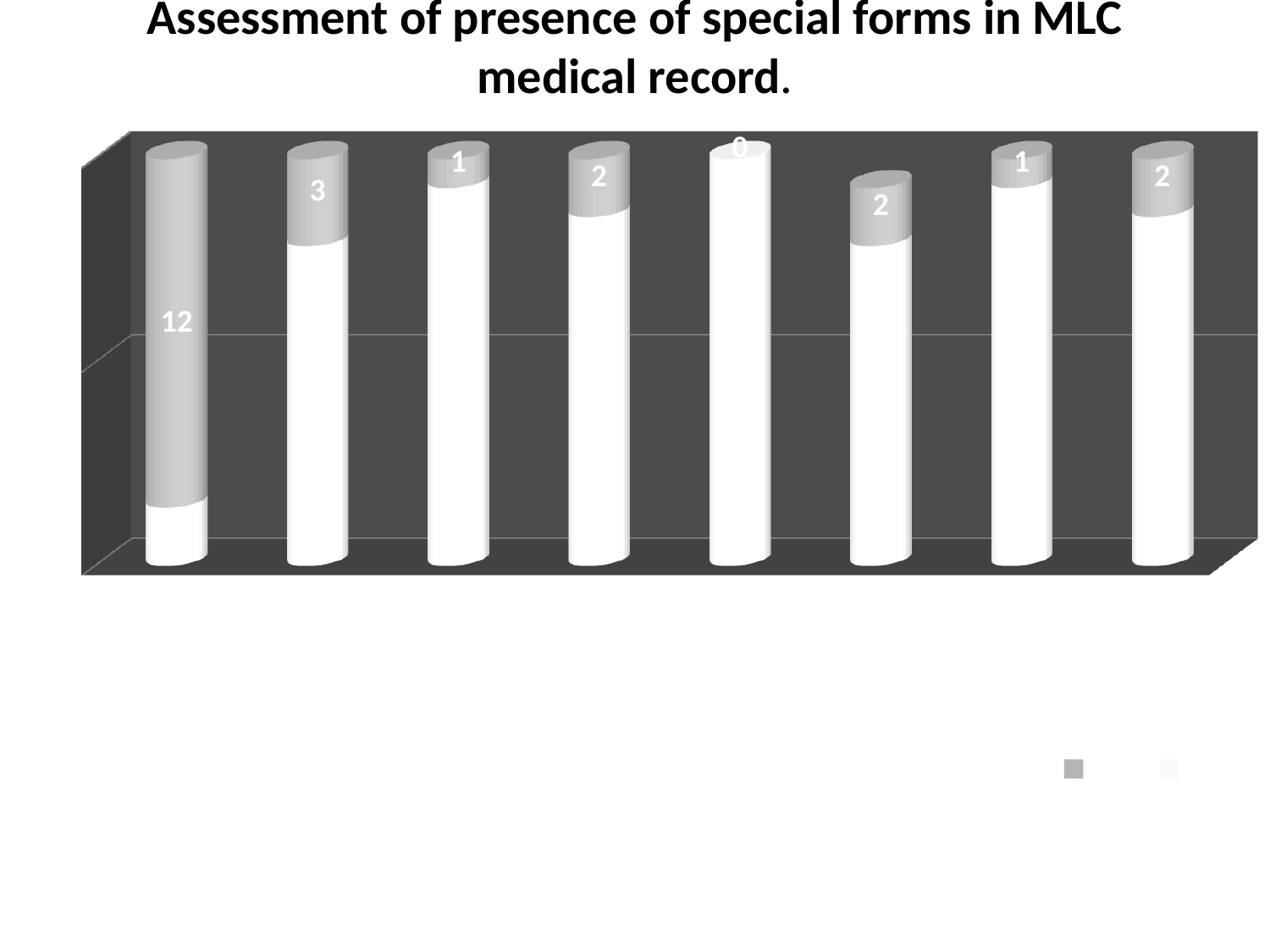
What is the labelled value of the grey segment on the fifth bar from the left? 0 What is the labelled value of the grey segment on the last bar on the right? 2 What kind of chart is shown on the slide? bar chart Which has the larger grey-segment value, the second bar from the left or the third bar from the left? the second bar from the left What is the difference between the grey-segment values of the first and second bars from the left? 9 Which bar has the highest labelled grey-segment value? the first bar from the left How many bars are plotted in the chart? 8 How many series does the legend list? 2 What is the labelled value of the grey segment on the second bar from the left? 3 What is the title of the chart? Assessment of presence of special forms in MLC medical record. What is the labelled value of the grey segment on the first bar from the left? 12 Which bar has the lowest labelled grey-segment value? the fifth bar from the left